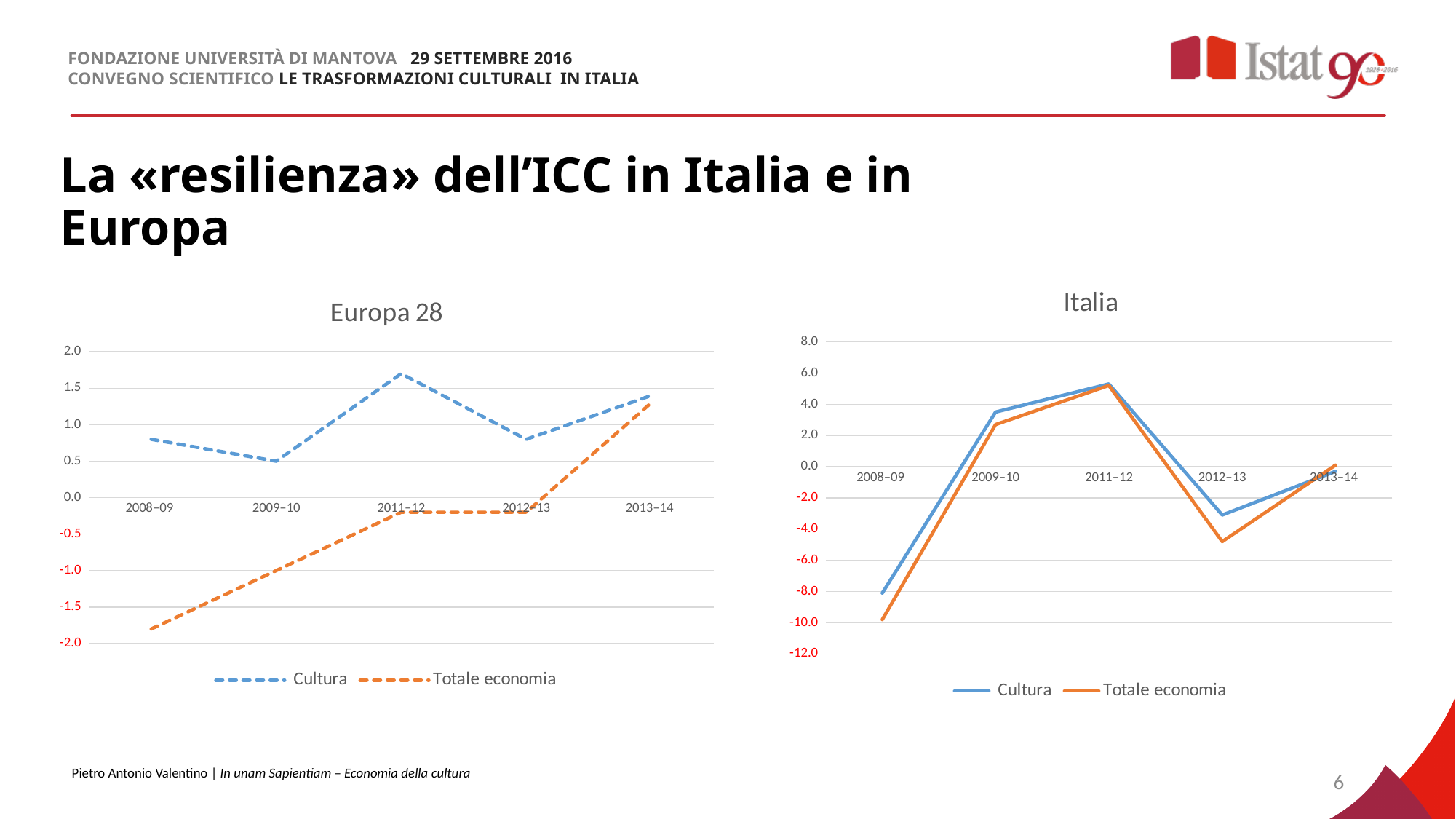
How many periods are shown on the x axis of the "Italia" chart? 5 In the "Europa 28" chart, in which period is the Totale economia series at its lowest? 2008–09 In the "Italia" chart, is the Totale economia value for 2008–09 greater or less than -8.0? less In the "Europa 28" chart, is the Cultura value for 2011–12 greater or less than 1.5? greater In the "Europa 28" chart, in which period does the Cultura series reach its highest value? 2011–12 In the "Italia" chart, does the Cultura series rise or fall from 2011–12 to 2012–13? fall How many series does the legend of the "Europa 28" chart list? 2 In the "Italia" chart, in which period does the Totale economia series reach its highest value? 2011–12 In the "Europa 28" chart, is the Totale economia value for 2008–09 greater or less than -1.5? less In the "Italia" chart, which series has the higher value in 2012–13, Cultura or Totale economia? Cultura In the "Italia" chart, in which period is the Cultura series at its lowest? 2008–09 What kind of chart is the "Europa 28" chart? line chart